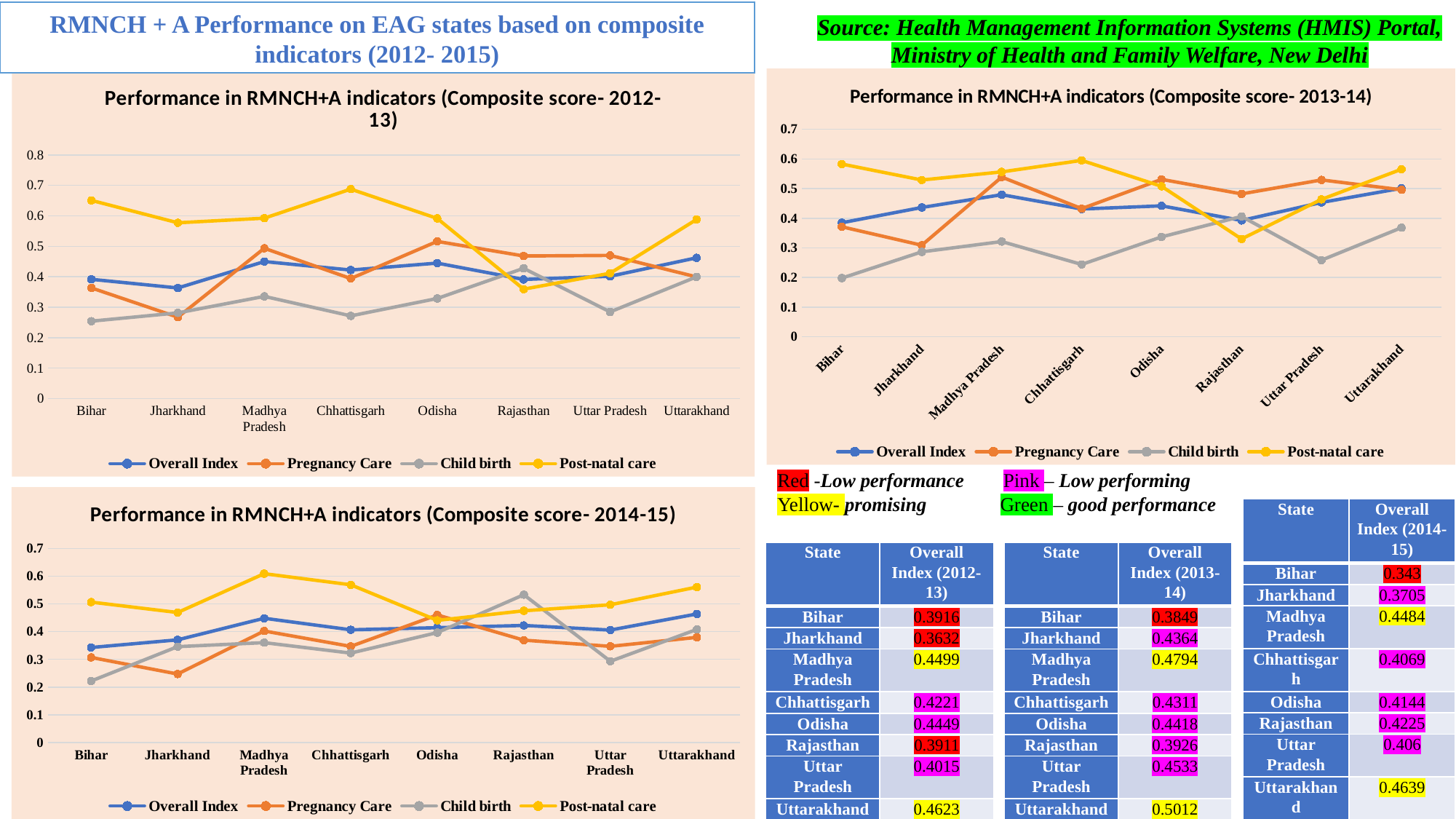
In the 'Composite score- 2012-13' chart, is the Post-natal care value for Bihar greater or less than 0.6? greater How many states are shown on the x axis of the 'Composite score- 2014-15' chart? 8 In the 'Composite score- 2014-15' chart, which state has the highest Post-natal care value? Madhya Pradesh How many series does the legend list in the 'Composite score- 2013-14' chart? 4 In the 'Composite score- 2013-14' chart, is the Post-natal care value for Rajasthan greater or less than 0.4? less In the 'Composite score- 2014-15' chart, which is larger for Rajasthan, Child birth or Pregnancy Care? Child birth In the 'Composite score- 2012-13' chart, which state has the highest Post-natal care value? Chhattisgarh In the 'Composite score- 2013-14' chart, which state has the lowest Child birth value? Bihar What type of chart is 'Performance in RMNCH+A indicators (Composite score- 2012-13)'? Line chart In the 'Composite score- 2014-15' chart, does the Overall Index rise or fall from Bihar to Madhya Pradesh? Rise In the 'Composite score- 2012-13' chart, which is larger for Bihar, Post-natal care or Child birth? Post-natal care In the 'Composite score- 2014-15' chart, is the Child birth value for Bihar greater or less than 0.3? less